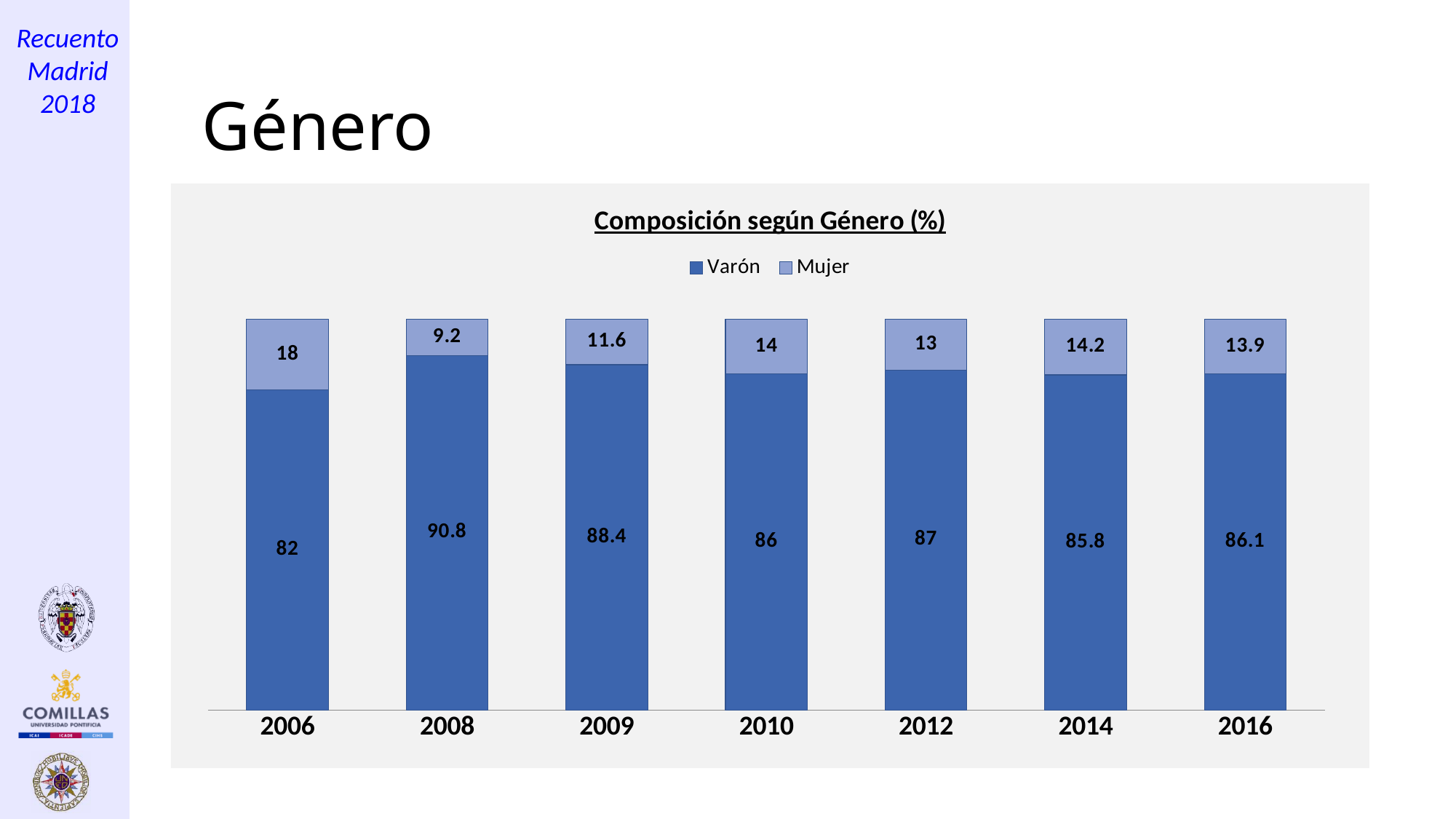
What is the difference between the Varón value in 2008 and the Varón value in 2006? 8.8 Which year has the highest Mujer value? 2006 How many years are shown on the x axis? 7 What is the Mujer value for 2014? 14.2 What kind of chart is shown on the slide? Stacked bar chart What is the Varón value for 2016? 86.1 Which year has the lowest Varón value? 2006 Which is larger, the Mujer value for 2010 or the Mujer value for 2012? 2010 Which year has the lowest Mujer value? 2008 What is the Mujer value for 2006? 18 How many series does the legend list? 2 What is the Varón value for 2008? 90.8